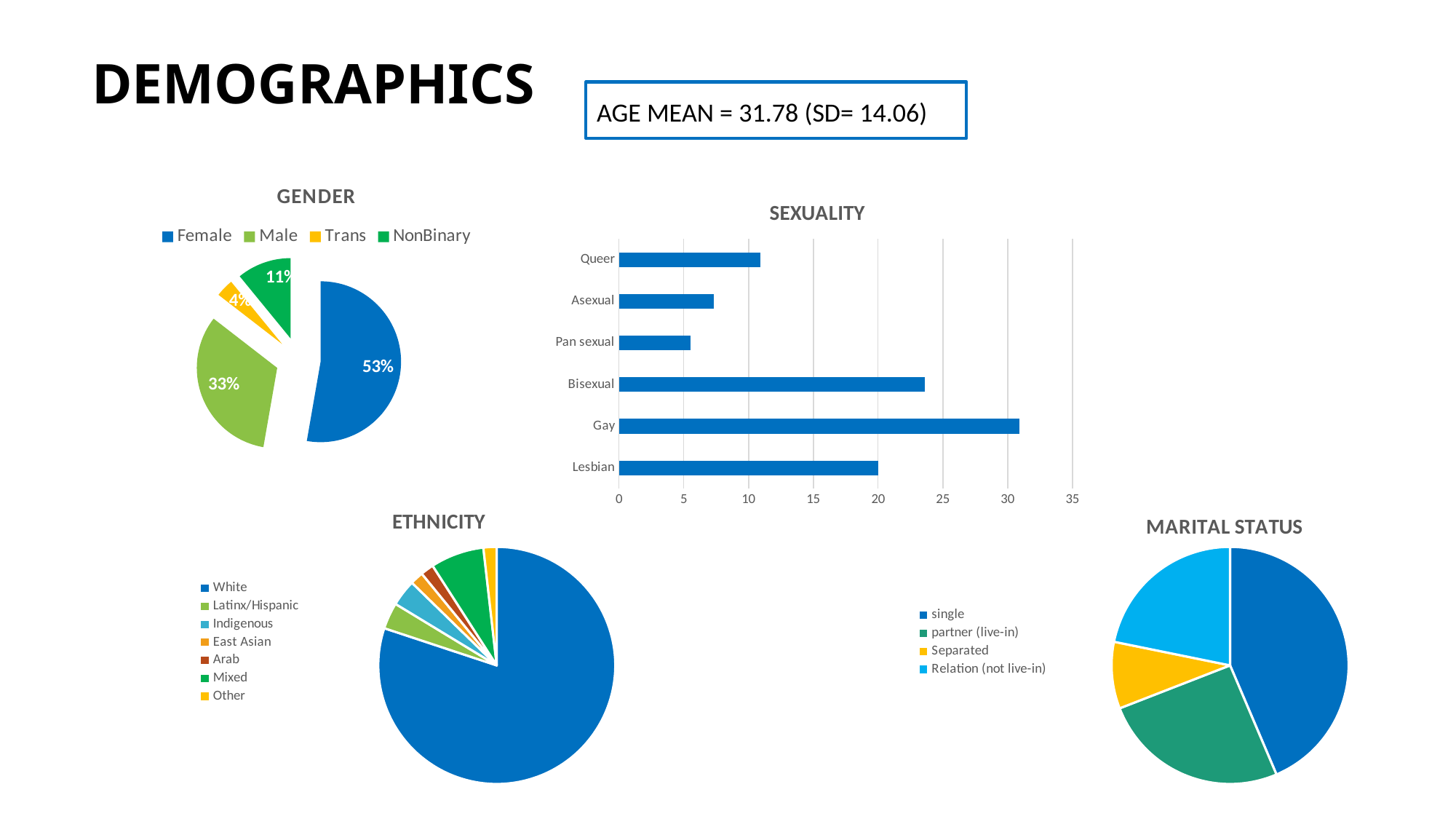
What kind of chart is the SEXUALITY chart? bar chart How many categories does the legend of the GENDER pie chart list? 4 In the GENDER pie chart, what percentage is Female? 53% In the SEXUALITY bar chart, which is larger, Lesbian or Bisexual? Bisexual In the GENDER pie chart, what percentage is Male? 33% In the GENDER pie chart, which category has the smallest share? Trans How many categories are shown in the SEXUALITY bar chart? 6 How many categories does the legend of the ETHNICITY pie chart list? 7 In the SEXUALITY bar chart, is the value for Bisexual greater or less than 20? greater In the GENDER pie chart, what percentage is NonBinary? 11% In the GENDER pie chart, what is the difference between the Female and Male shares? 20% In the SEXUALITY bar chart, which category has the highest value? Gay